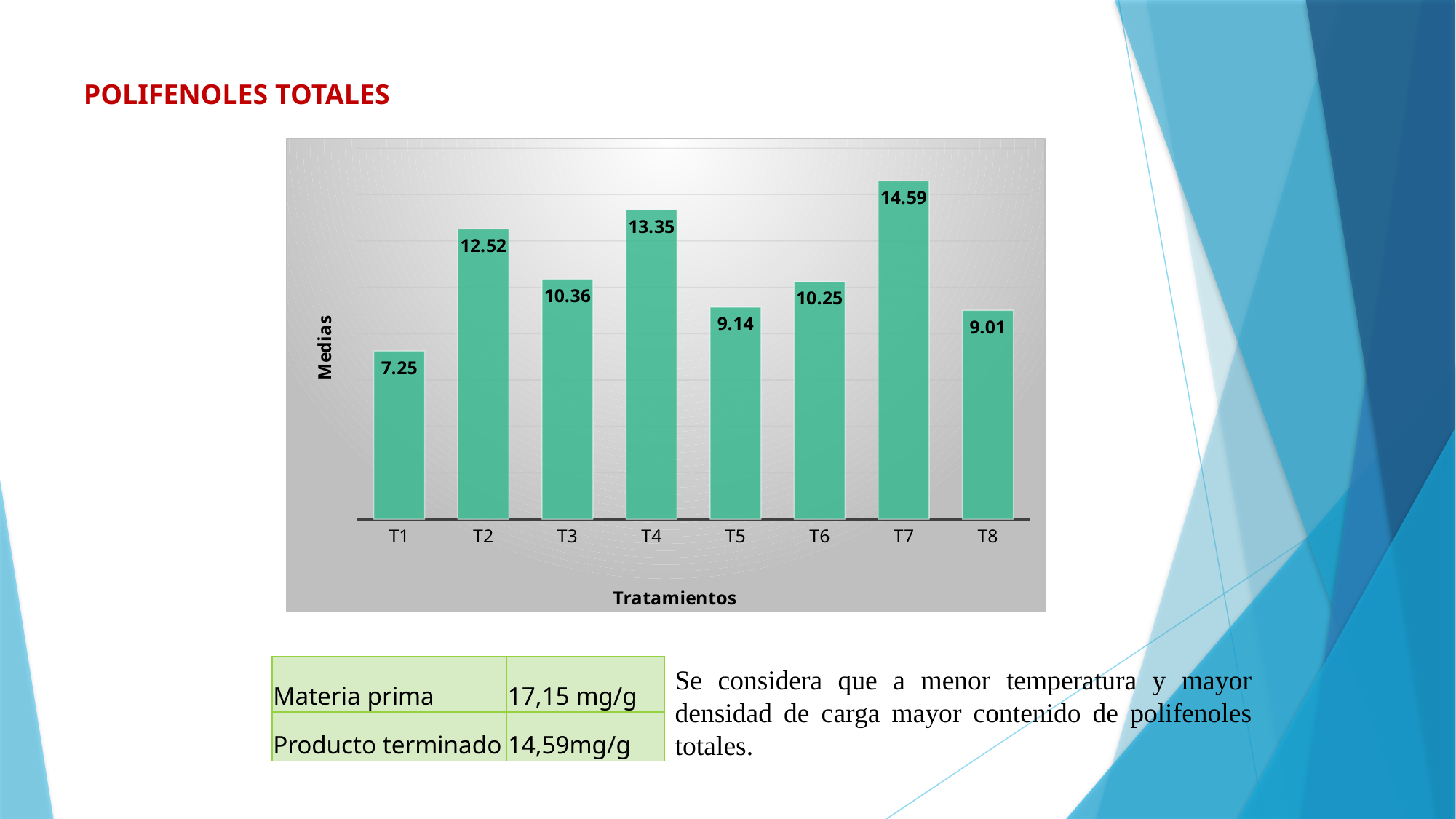
How many treatments are shown on the x axis? 8 What kind of chart is shown? Bar chart What is the label of the x axis? Tratamientos What is the difference between the values for T2 and T3? 2.16 Which treatment has the highest value? T7 Which is larger, the value for T2 or the value for T4? T4 What is the value for T6? 10.25 Which is larger, the value for T5 or the value for T8? T5 Which treatment has the lowest value? T1 What is the difference between the values for T7 and T1? 7.34 What is the value for T1? 7.25 What is the value for T4? 13.35